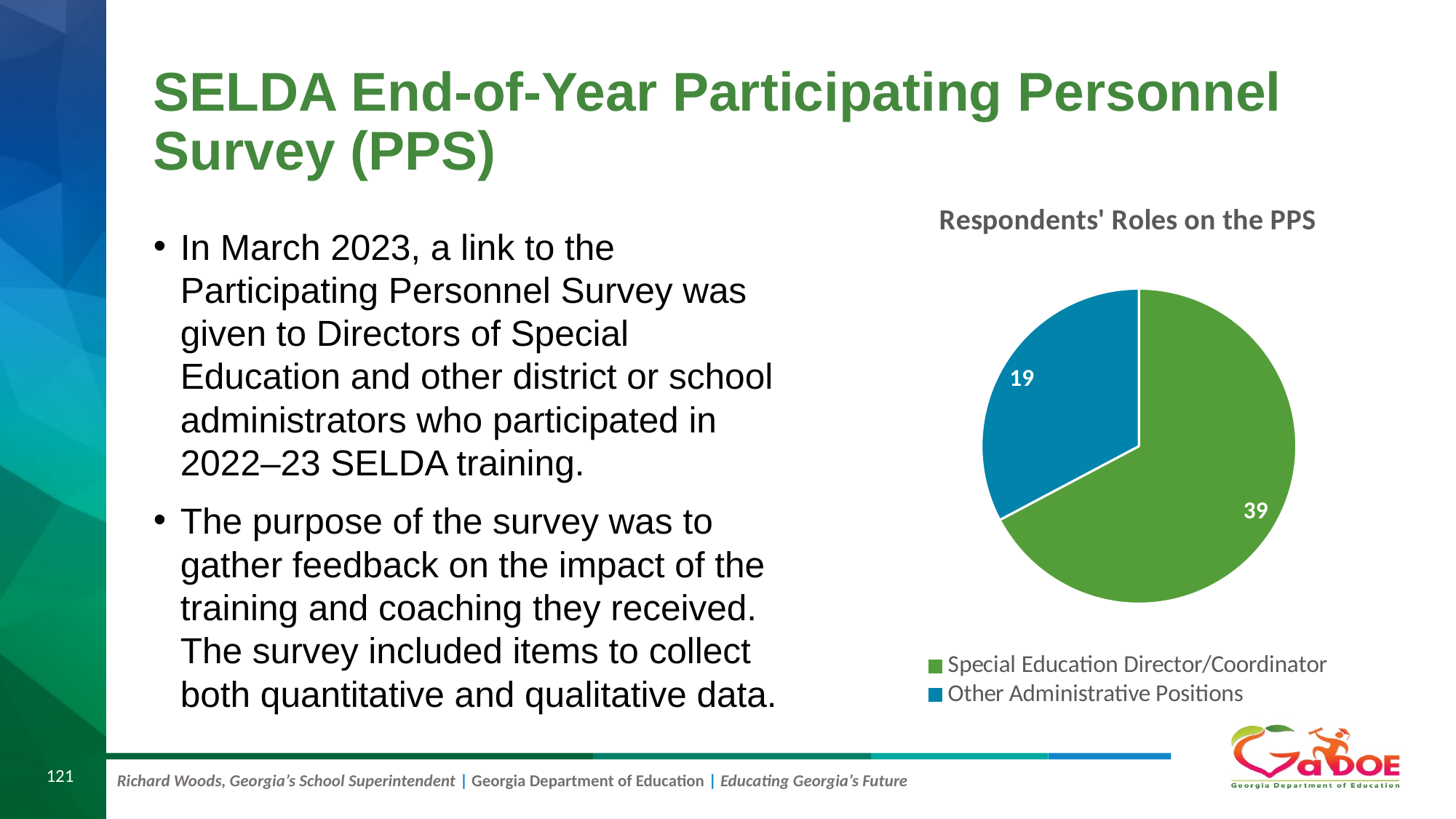
How many respondents held Other Administrative Positions? 19 What is the total number of respondents shown in the pie chart? 58 How many respondents were Special Education Director/Coordinator? 39 How many categories does the pie chart show? 2 Which role has the smallest slice of the pie? Other Administrative Positions What is the difference between the number of Special Education Director/Coordinator respondents and Other Administrative Positions respondents? 20 Which role has the largest slice of the pie? Special Education Director/Coordinator What is the title of the chart? Respondents' Roles on the PPS What colour is the slice for Other Administrative Positions? blue Which is larger: the number of Special Education Director/Coordinator respondents or Other Administrative Positions respondents? Special Education Director/Coordinator What type of chart is shown on the slide? pie chart